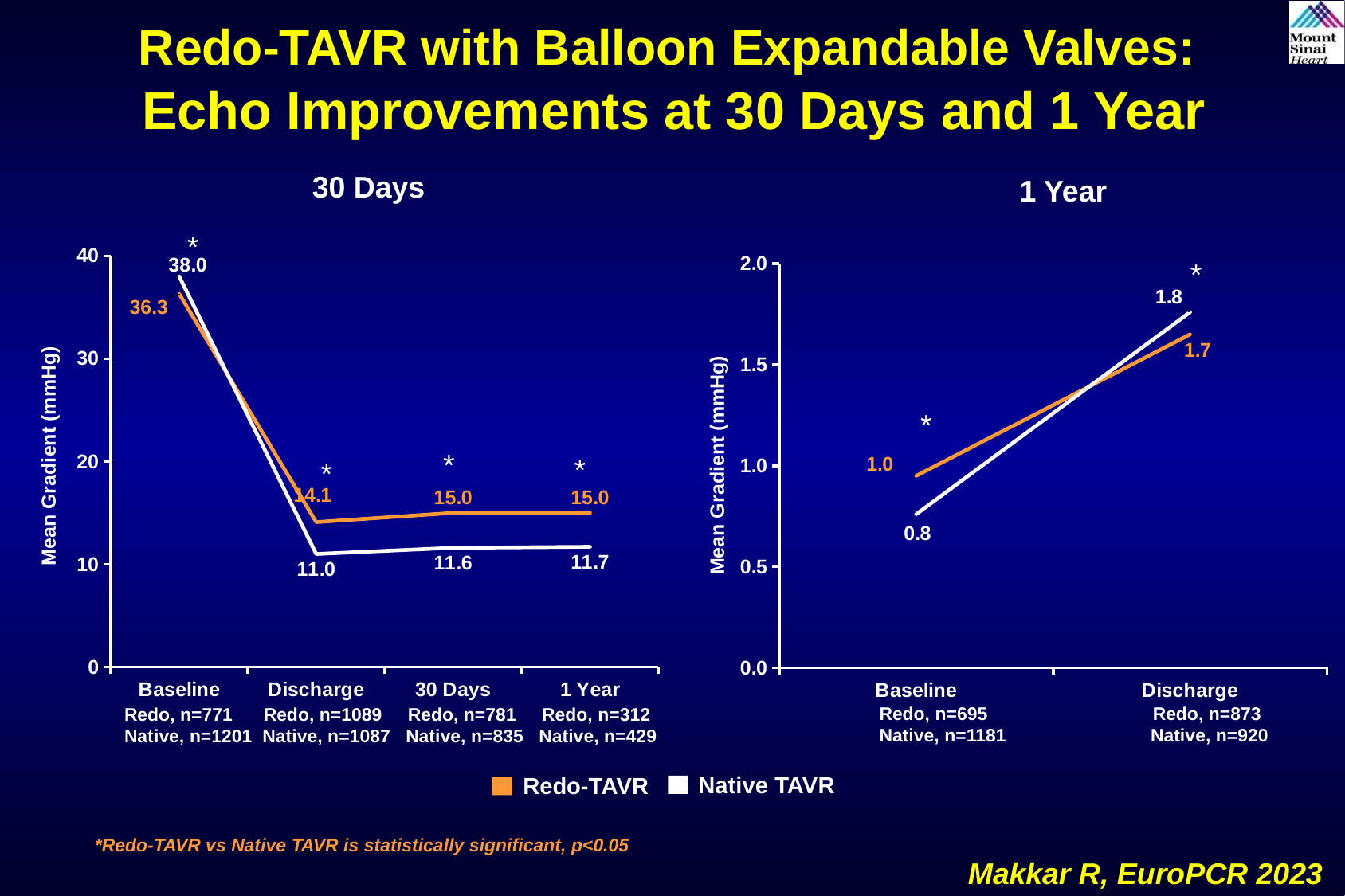
In the left chart titled "30 Days", at which time point is the Native TAVR mean gradient highest? Baseline In the left chart titled "30 Days", how many time points are shown on the x axis? 4 In the right chart titled "1 Year", what is the difference between the Native TAVR mean gradient at Discharge and at Baseline? 1.0 In the left chart titled "30 Days", what is the difference between the Redo-TAVR and Native TAVR mean gradients at 30 Days? 3.4 In the right chart titled "1 Year", does the Native TAVR mean gradient rise or fall from Baseline to Discharge? rise In the left chart titled "30 Days", which series has the higher mean gradient at Baseline, Redo-TAVR or Native TAVR? Native TAVR In the left chart titled "30 Days", what is the mean gradient for Native TAVR at 1 Year? 11.7 In the left chart titled "30 Days", at which time point is the Redo-TAVR mean gradient lowest? Discharge In the right chart titled "1 Year", what is the mean gradient for Redo-TAVR at Discharge? 1.7 How many series does the legend list? 2 In the left chart titled "30 Days", what is the mean gradient for Redo-TAVR at Baseline? 36.3 In the left chart titled "30 Days", what is the mean gradient for Native TAVR at Discharge? 11.0